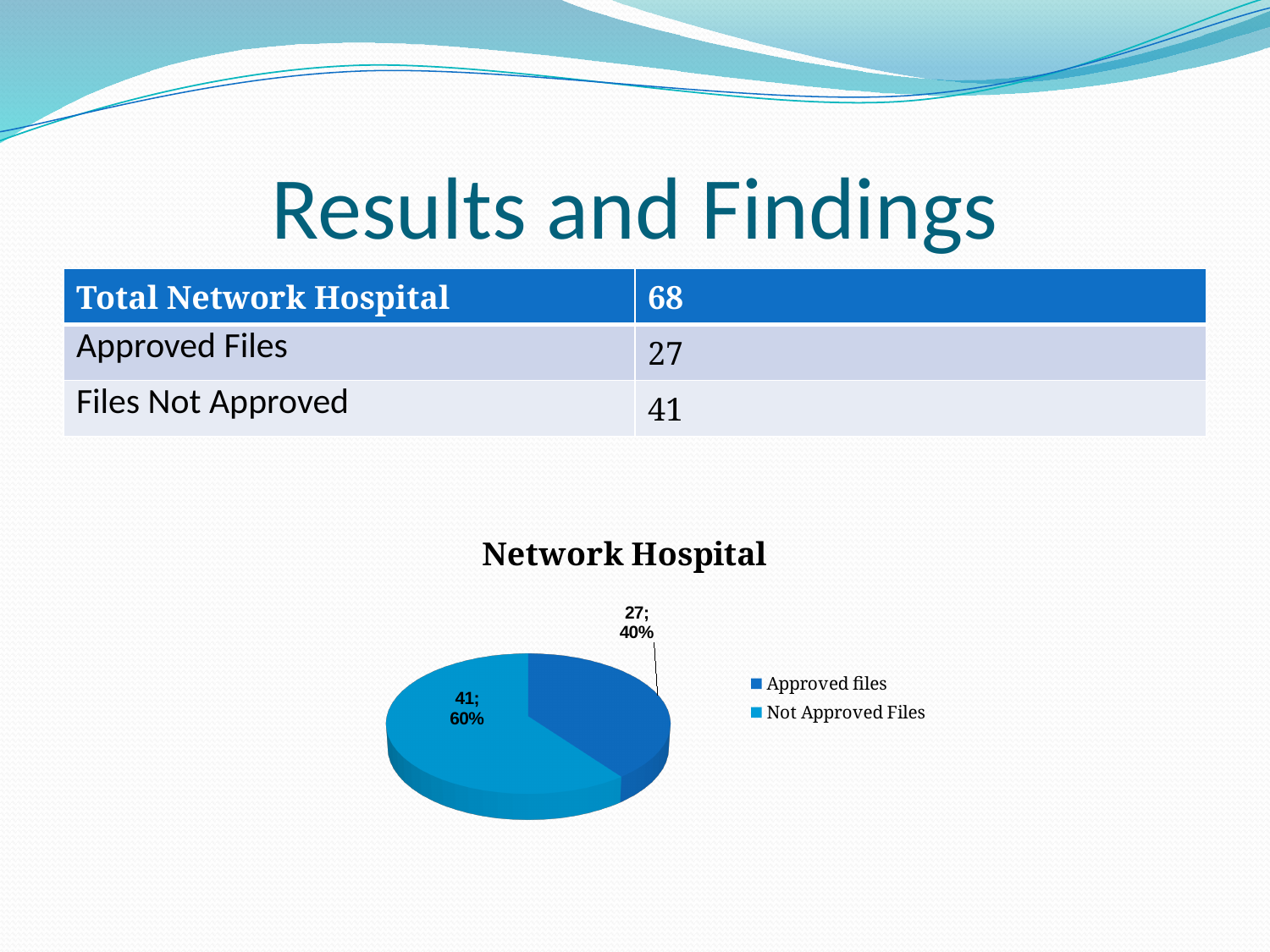
What is the title of the chart? Network Hospital What is the value for Not Approved Files? 41 How many entries does the legend list? 2 What type of chart is shown on the slide? pie chart What is the difference between the Not Approved Files value and the Approved files value? 14 Which slice is the smallest? Approved files What share of the pie is Approved files? 40% Which is larger, Approved files or Not Approved Files? Not Approved Files How many slices does the pie chart have? 2 What is the value for Approved files? 27 Which slice is the largest? Not Approved Files What share of the pie is Not Approved Files? 60%